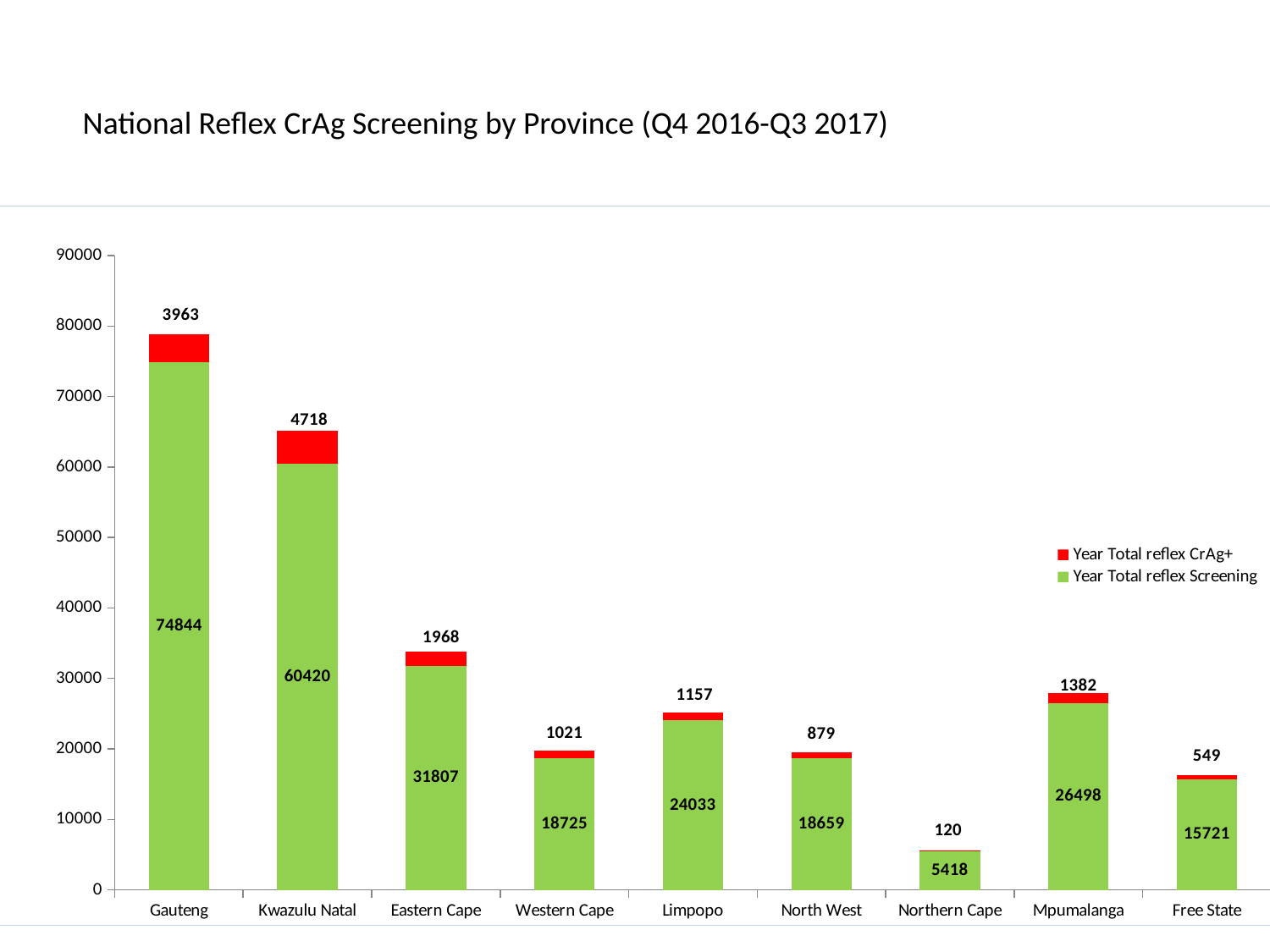
Which province has the lowest Year Total reflex CrAg+ value? Northern Cape Which province has the highest Year Total reflex Screening value? Gauteng What is the Year Total reflex Screening value for Gauteng? 74844 What is the Year Total reflex Screening value for Northern Cape? 5418 What kind of chart is shown on the slide? Stacked bar chart Which has a larger Year Total reflex CrAg+ value, Gauteng or Kwazulu Natal? Kwazulu Natal Which colour represents the Year Total reflex CrAg+ series? Red What is the total height of the stacked bar for Eastern Cape (Screening plus CrAg+)? 33775 How many series does the legend list? 2 What is the difference between the Year Total reflex Screening values for Gauteng and Kwazulu Natal? 14424 What is the Year Total reflex CrAg+ value for Kwazulu Natal? 4718 How many provinces are shown on the x axis? 9